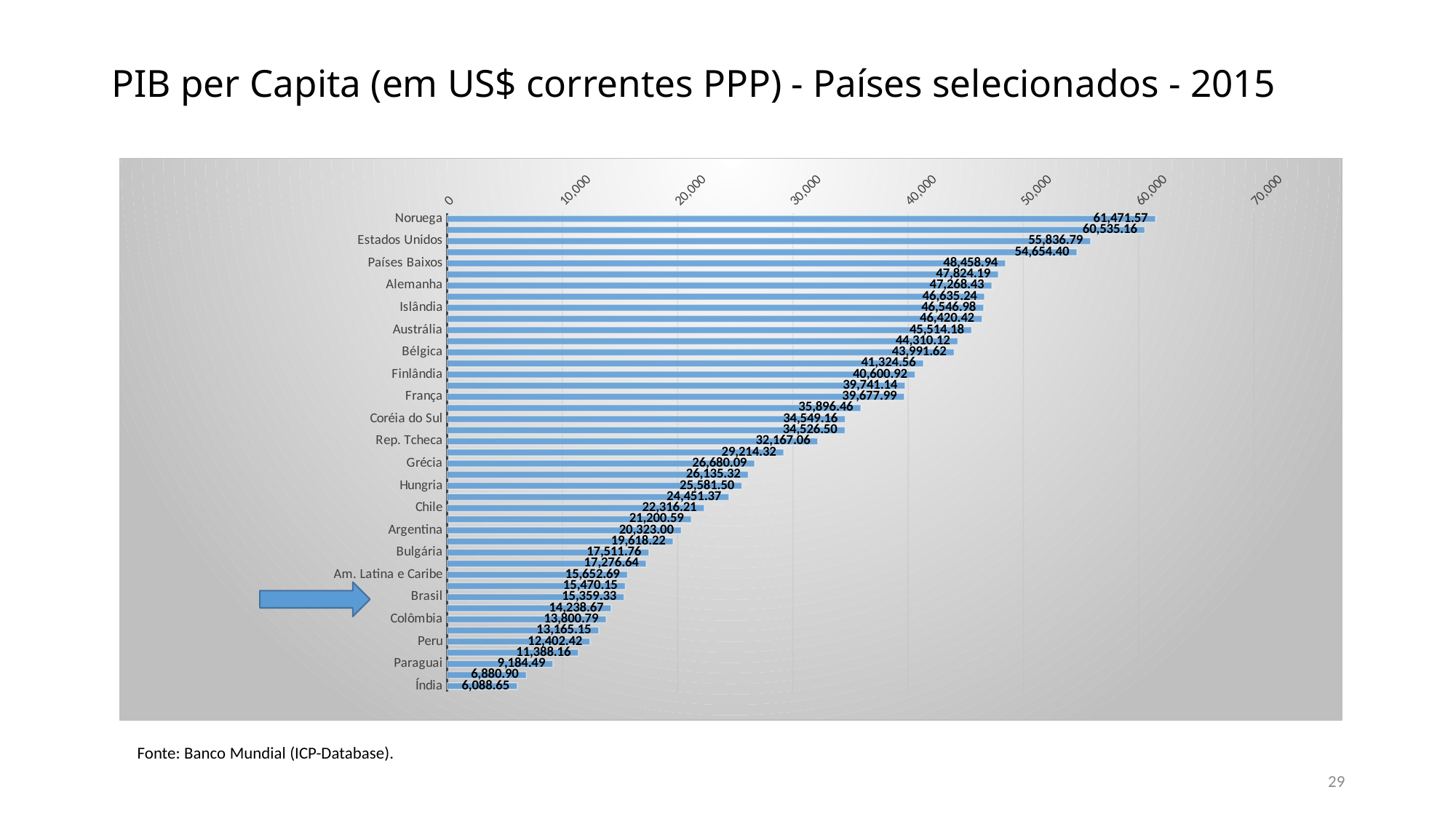
What is the value shown for Noruega? 61,471.57 Is the value for Alemanha greater or less than 40,000? greater Which has a higher value, Chile or Argentina? Chile What is the difference between the values for Noruega and Estados Unidos? 5,634.78 Do the values rise or fall going from the top of the chart to the bottom? Fall What is the GDP per capita value shown for Brasil? 15,359.33 Which country's bar is marked with an arrow on the slide? Brasil Which country has the lowest GDP per capita in the chart? Índia What is the value shown for Índia? 6,088.65 What type of chart is shown on the slide? Bar chart What is the value shown for Estados Unidos? 55,836.79 Which country has the highest GDP per capita in the chart? Noruega